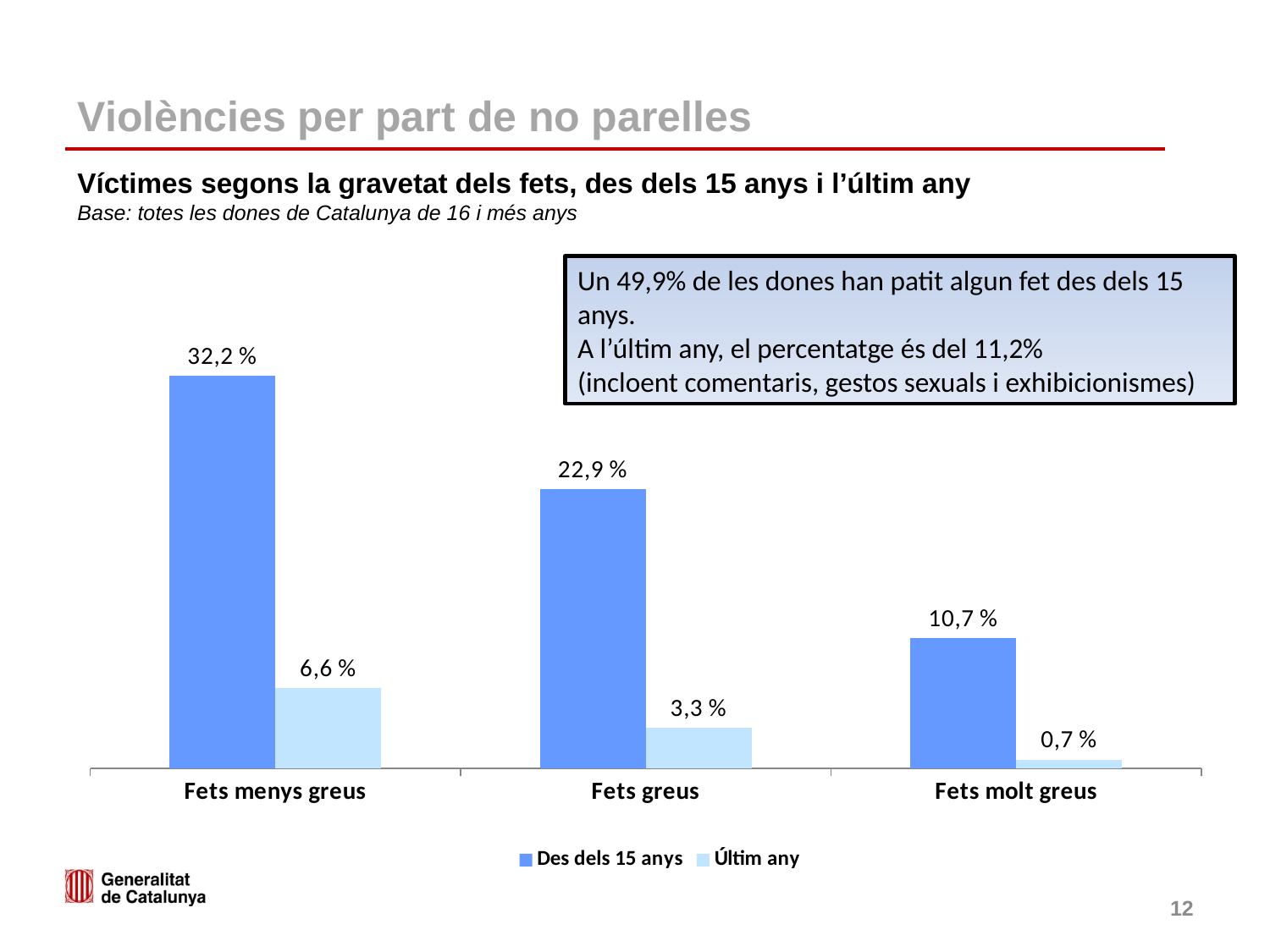
How many categories are shown on the x axis? 3 What is the difference between the "Des dels 15 anys" values for "Fets menys greus" and "Fets molt greus"? 21,5 % Do the "Des dels 15 anys" values rise or fall from left to right across the categories? Fall What is the value for "Últim any" in the "Fets greus" category? 3,3 % What kind of chart is shown on the slide? Bar chart How many series does the legend list? 2 Which is larger: the "Últim any" value for "Fets menys greus" or the "Des dels 15 anys" value for "Fets molt greus"? Des dels 15 anys for Fets molt greus Which category has the lowest value for "Últim any"? Fets molt greus Which category has the highest value for "Des dels 15 anys"? Fets menys greus What is the value for "Des dels 15 anys" in the "Fets menys greus" category? 32,2 % What is the difference between the "Des dels 15 anys" and "Últim any" values for "Fets greus"? 19,6 % What is the value for "Últim any" in the "Fets molt greus" category? 0,7 %